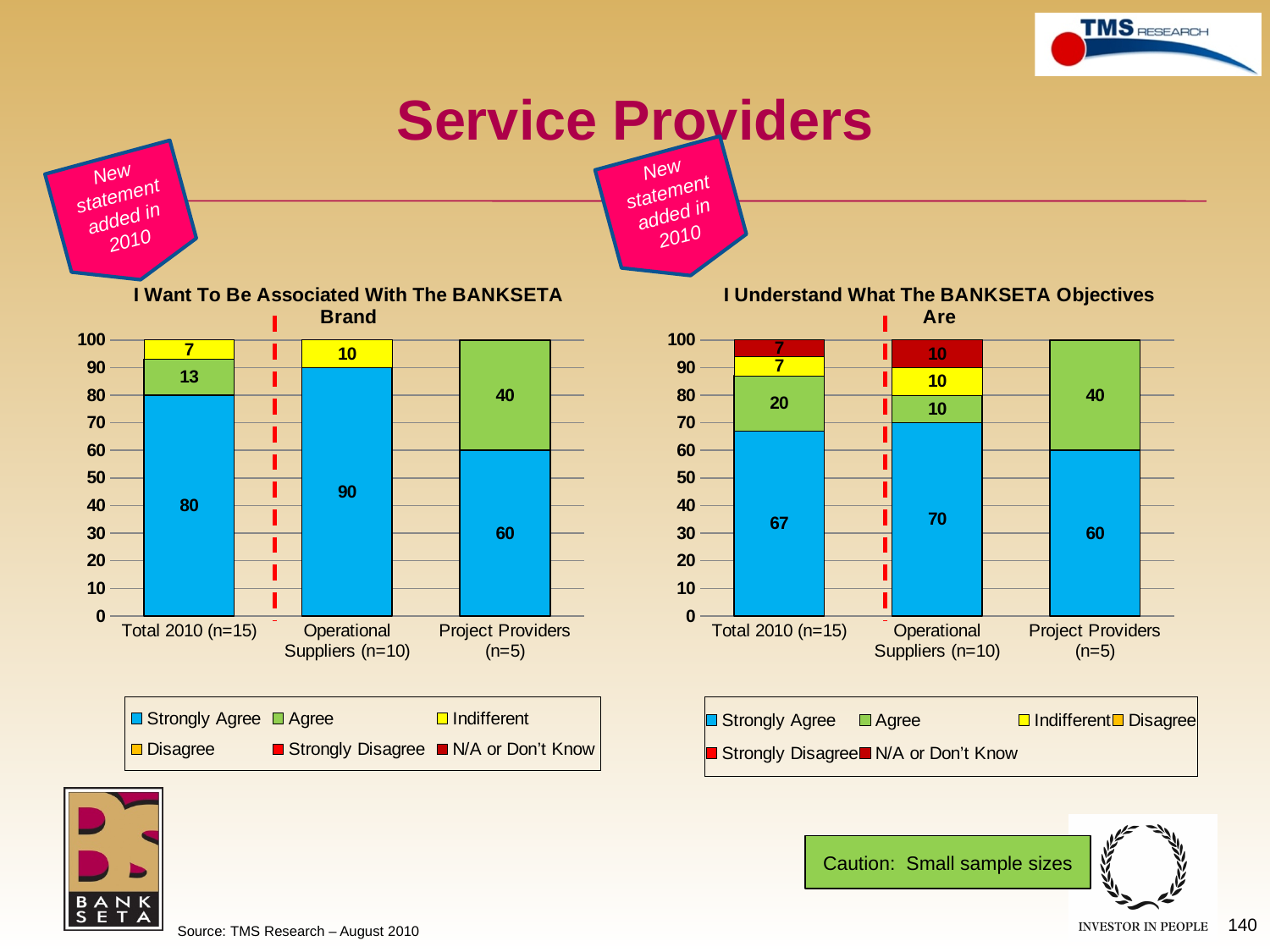
How many categories are shown on the x axis of the chart titled "I Understand What The BANKSETA Objectives Are"? 3 What kind of chart is the chart titled "I Understand What The BANKSETA Objectives Are"? Stacked bar chart In the chart titled "I Understand What The BANKSETA Objectives Are", which category has the lowest Strongly Agree value? Project Providers (n=5) In the chart titled "I Want To Be Associated With The BANKSETA Brand", what is the difference between the Strongly Agree values for Operational Suppliers (n=10) and Project Providers (n=5)? 30 In the chart titled "I Want To Be Associated With The BANKSETA Brand", what is the Strongly Agree value for Operational Suppliers (n=10)? 90 In the chart titled "I Want To Be Associated With The BANKSETA Brand", what is the total of the stacked bar for Operational Suppliers (n=10)? 100 In the chart titled "I Want To Be Associated With The BANKSETA Brand", which category has the highest Strongly Agree value? Operational Suppliers (n=10) How many series does the legend of the chart titled "I Want To Be Associated With The BANKSETA Brand" list? 6 In the chart titled "I Understand What The BANKSETA Objectives Are", is the Strongly Agree value for Total 2010 (n=15) larger or smaller than that for Operational Suppliers (n=10)? smaller In the chart titled "I Understand What The BANKSETA Objectives Are", what is the Strongly Agree value for Total 2010 (n=15)? 67 In the chart titled "I Understand What The BANKSETA Objectives Are", what is the Agree value for Project Providers (n=5)? 40 In the chart titled "I Want To Be Associated With The BANKSETA Brand", what is the Agree value for Total 2010 (n=15)? 13